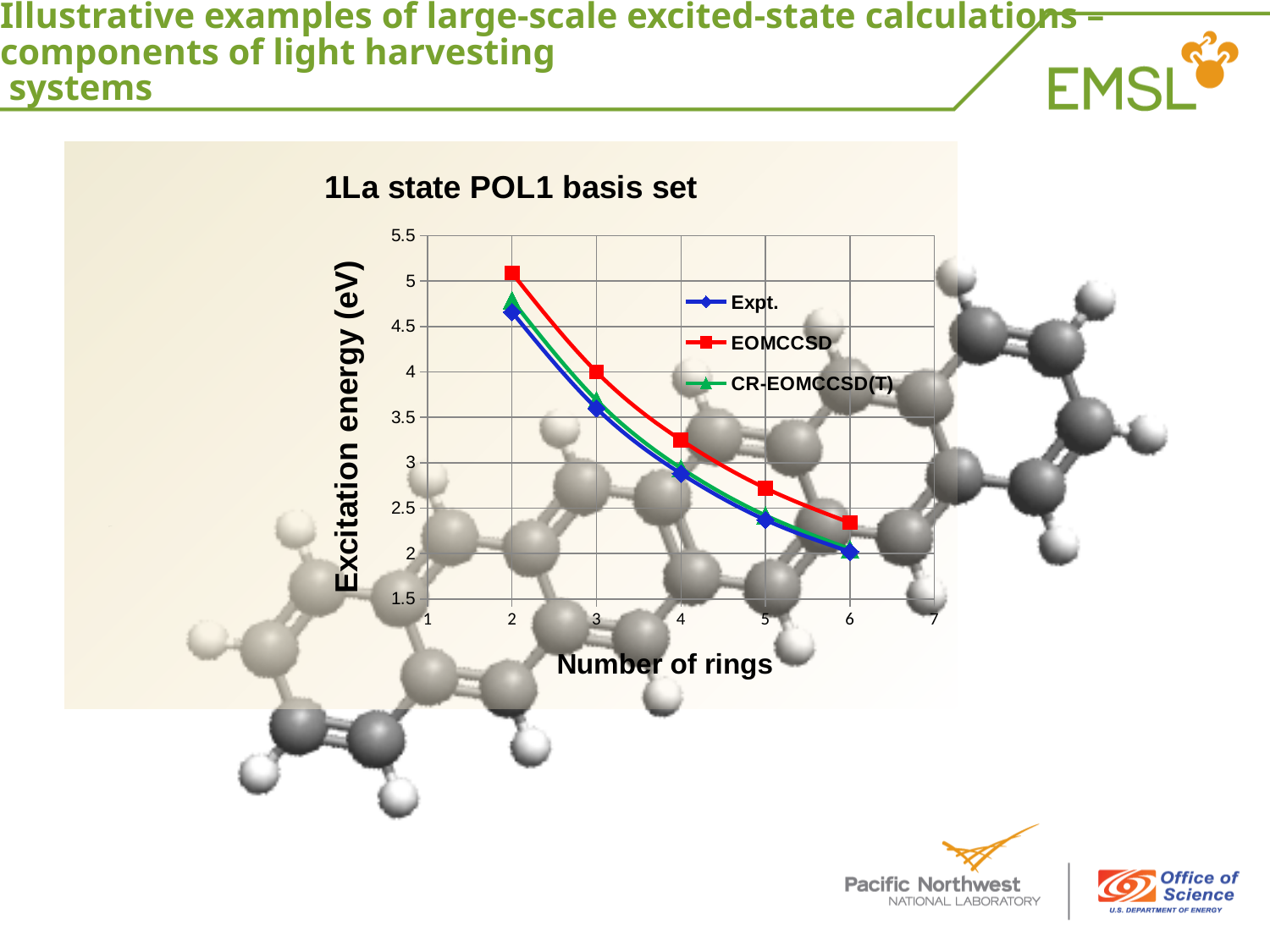
Is the EOMCCSD value at 4 rings greater or less than 3? greater What is the title of the chart? 1La state POL1 basis set Do the excitation energies rise or fall as the number of rings increases? fall Which series has the lowest excitation energy at 3 rings? Expt. At 4 rings, which is larger: the EOMCCSD value or the Expt. value? EOMCCSD How many data points are plotted for the EOMCCSD series? 5 Is the Expt. value at 6 rings greater or less than 2.5? less What is the label of the y axis? Excitation energy (eV) How many series does the legend list? 3 What kind of chart is shown on the slide? line chart Is the EOMCCSD value at 2 rings greater or less than 5? greater Which series has the highest excitation energy at 2 rings? EOMCCSD